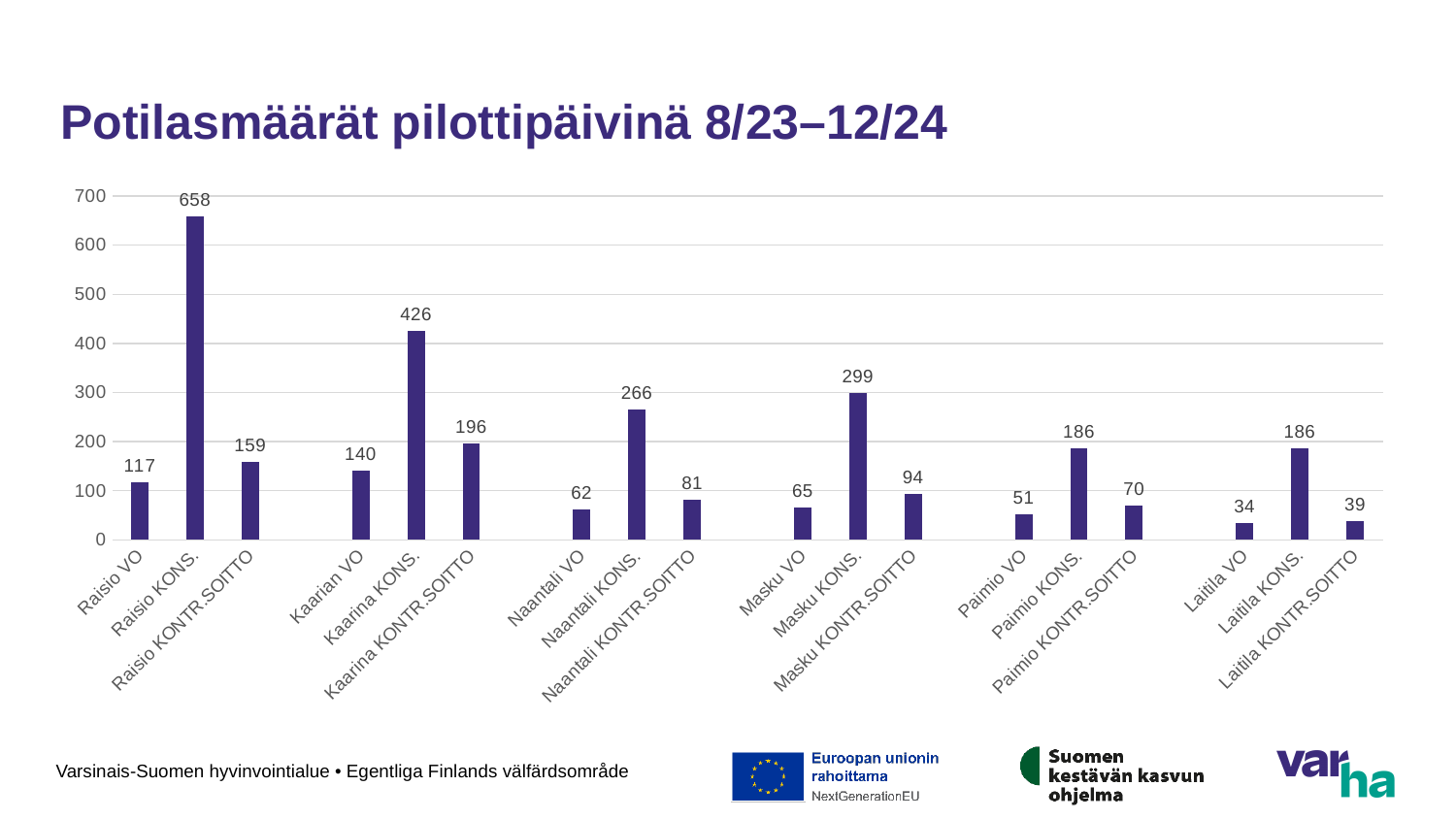
What is the value for Laitila VO? 34 Which is larger, Raisio KONTR.SOITTO or Kaarina KONTR.SOITTO? Kaarina KONTR.SOITTO Is the value for Paimio KONS. greater or less than 100? greater What is the value for Masku KONS.? 299 What kind of chart is shown on the slide? Bar chart What is the value for Naantali KONTR.SOITTO? 81 What is the value for Raisio KONS.? 658 What is the difference between Kaarina KONS. and Naantali KONS.? 160 Which category has the highest value? Raisio KONS. Which category has the lowest value? Laitila VO What is the title of the chart? Potilasmäärät pilottipäivinä 8/23–12/24 How many categories are shown on the x axis? 18